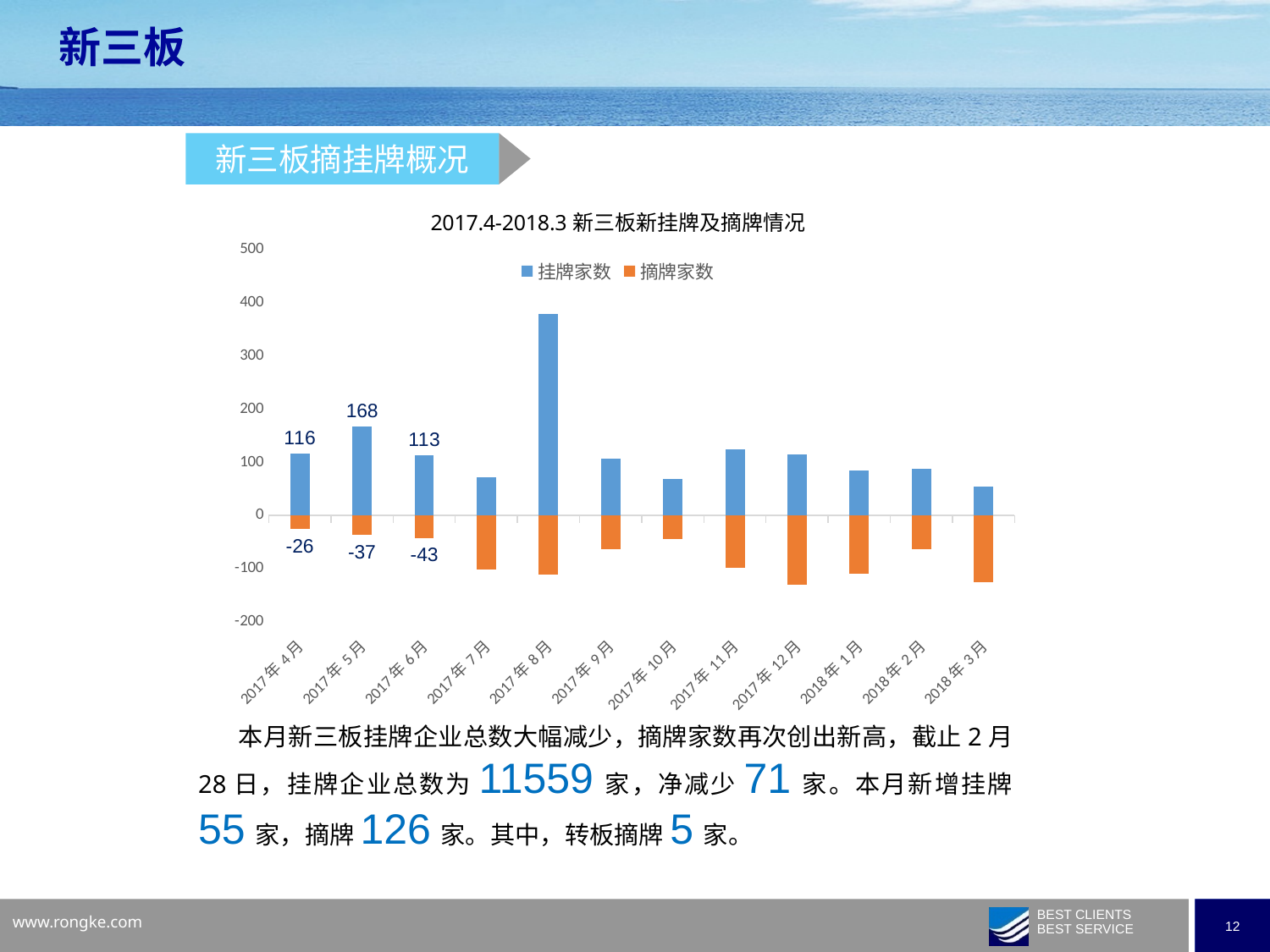
Is the 挂牌家数 value for 2017年8月 greater or less than 300? greater What is the difference between the 挂牌家数 values for 2017年5月 and 2017年4月? 52 What is the value of 摘牌家数 for 2017年6月? -43 What is the value of 挂牌家数 for 2017年4月? 116 Which is larger, the 挂牌家数 for 2017年5月 or for 2017年6月? 2017年5月 What is the value of 摘牌家数 for 2017年4月? -26 What is the value of 挂牌家数 for 2017年5月? 168 Which month has the highest 挂牌家数? 2017年8月 How many series does the chart legend list? 2 What type of chart is shown on the slide? bar chart How many months are shown on the x axis of the chart? 12 Is the 挂牌家数 value for 2017年7月 greater or less than 100? less